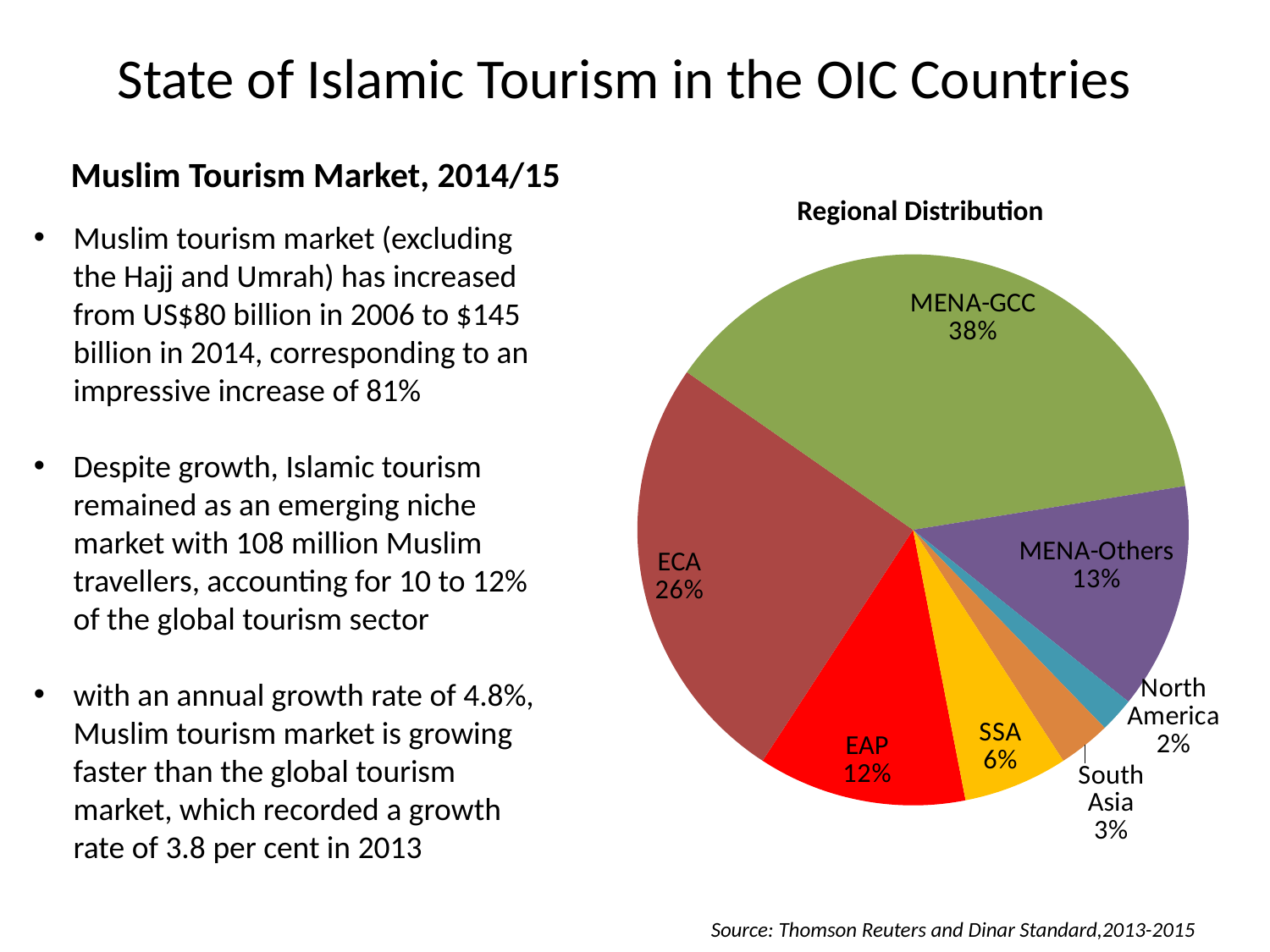
What is the difference in percentage points between MENA-GCC and ECA? 12 What is the title of the pie chart? Regional Distribution How many regions are shown in the pie chart? 7 What is the value shown for South Asia? 3% What kind of chart is shown under the title "Regional Distribution"? pie chart What is the value shown for MENA-Others? 13% Which region has the smallest slice of the pie? North America What share of the pie does MENA-GCC hold? 38% Which is larger, the share for SSA or the share for South Asia? SSA What is the value shown for EAP? 12% What is the value shown for ECA? 26% Which region has the largest slice of the pie? MENA-GCC